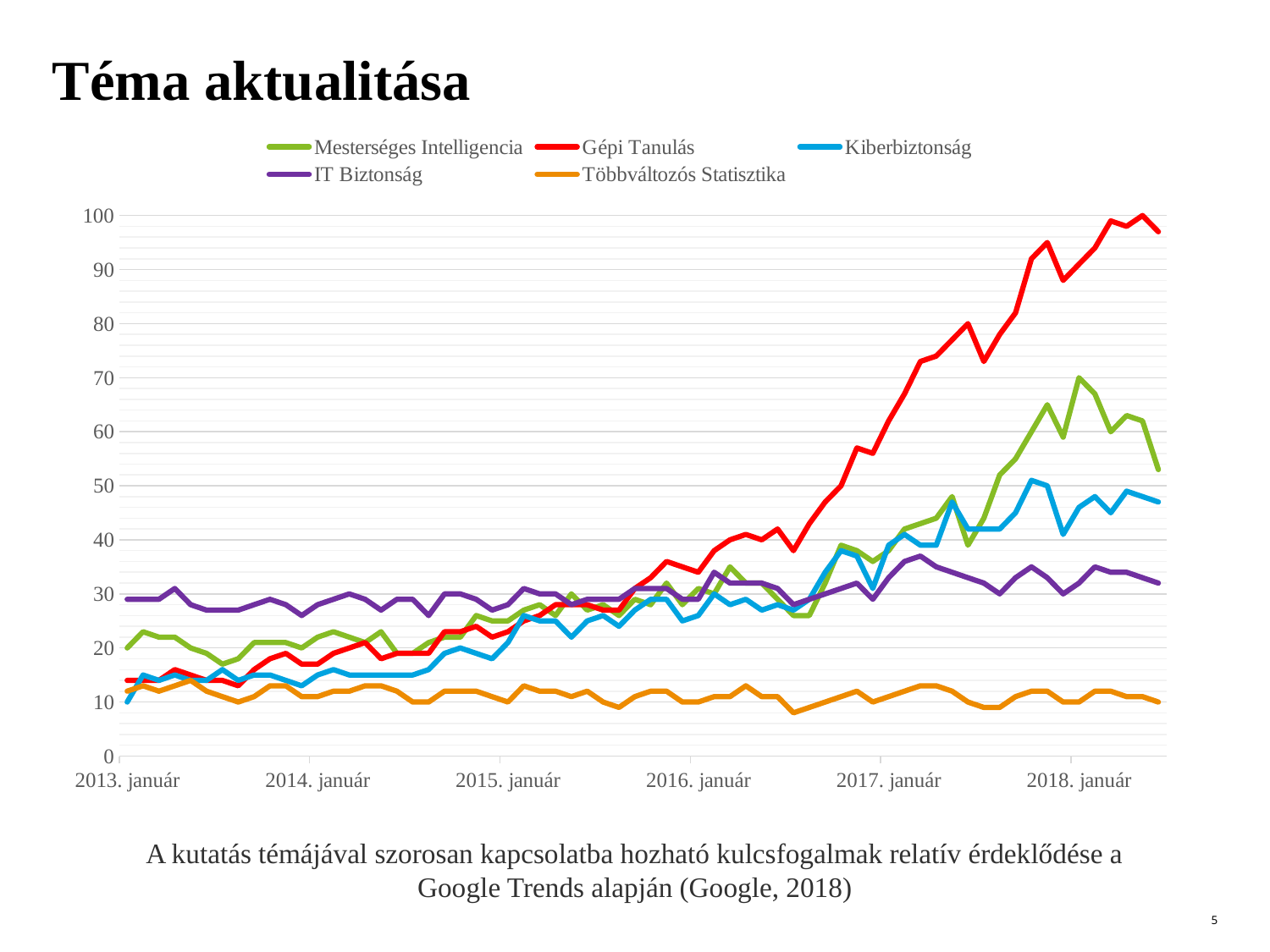
How many series does the legend list? 5 What kind of chart is shown on the slide? line chart Which series is drawn in orange? Többváltozós Statisztika At 2018. január, which is larger: the value for Gépi Tanulás or the value for IT Biztonság? Gépi Tanulás Which series reaches the highest value on the chart? Gépi Tanulás Does the value for Gépi Tanulás rise or fall from 2013 to 2018? rise Is the value for Mesterséges Intelligencia at 2018. január greater or less than 50? greater Is the value for Többváltozós Statisztika at 2017. január greater or less than 20? less Which series is drawn in red? Gépi Tanulás At 2014. január, which is larger: the value for IT Biztonság or the value for Kiberbiztonság? IT Biztonság Is the value for Gépi Tanulás at 2018. január greater or less than 80? greater